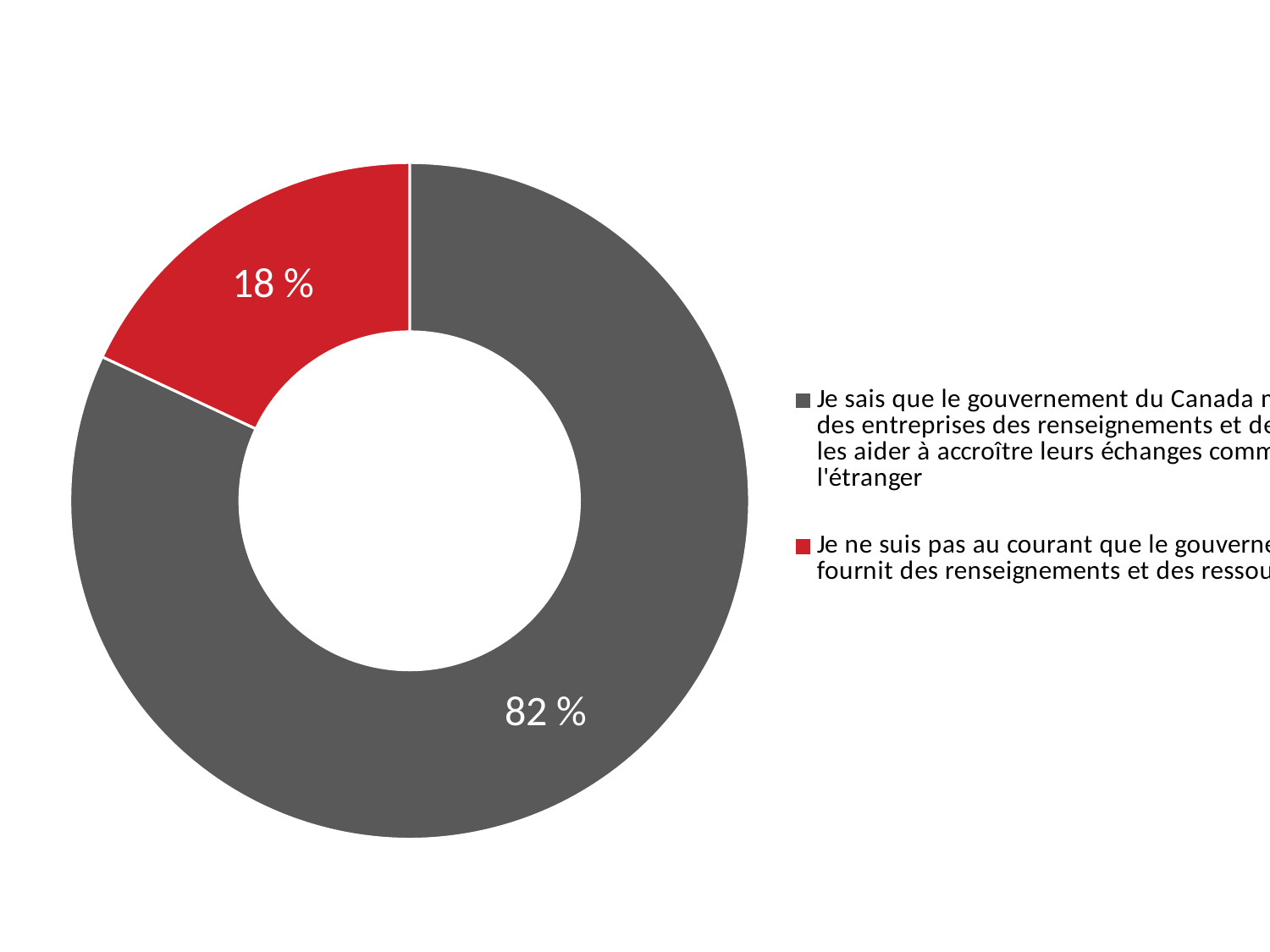
What percentage is shown for the red slice of the donut chart? 18 % What is the value of the slice labelled "Je ne suis pas au courant que le gouverne..." in the legend? 18 % Which slice of the donut chart is the smallest? The red slice (18 %) How many slices does the donut chart have? 2 What percentage is shown for the grey slice of the donut chart? 82 % What is the value of the slice labelled "Je sais que le gouvernement du Canada..." in the legend? 82 % What kind of chart is shown on the slide? Pie chart (donut) What colour is the slice representing 18 %? Red Which is larger, the grey slice or the red slice? The grey slice How many entries does the legend list? 2 Which slice of the donut chart is the largest? The grey slice (82 %) What is the difference in percentage points between the grey slice and the red slice? 64